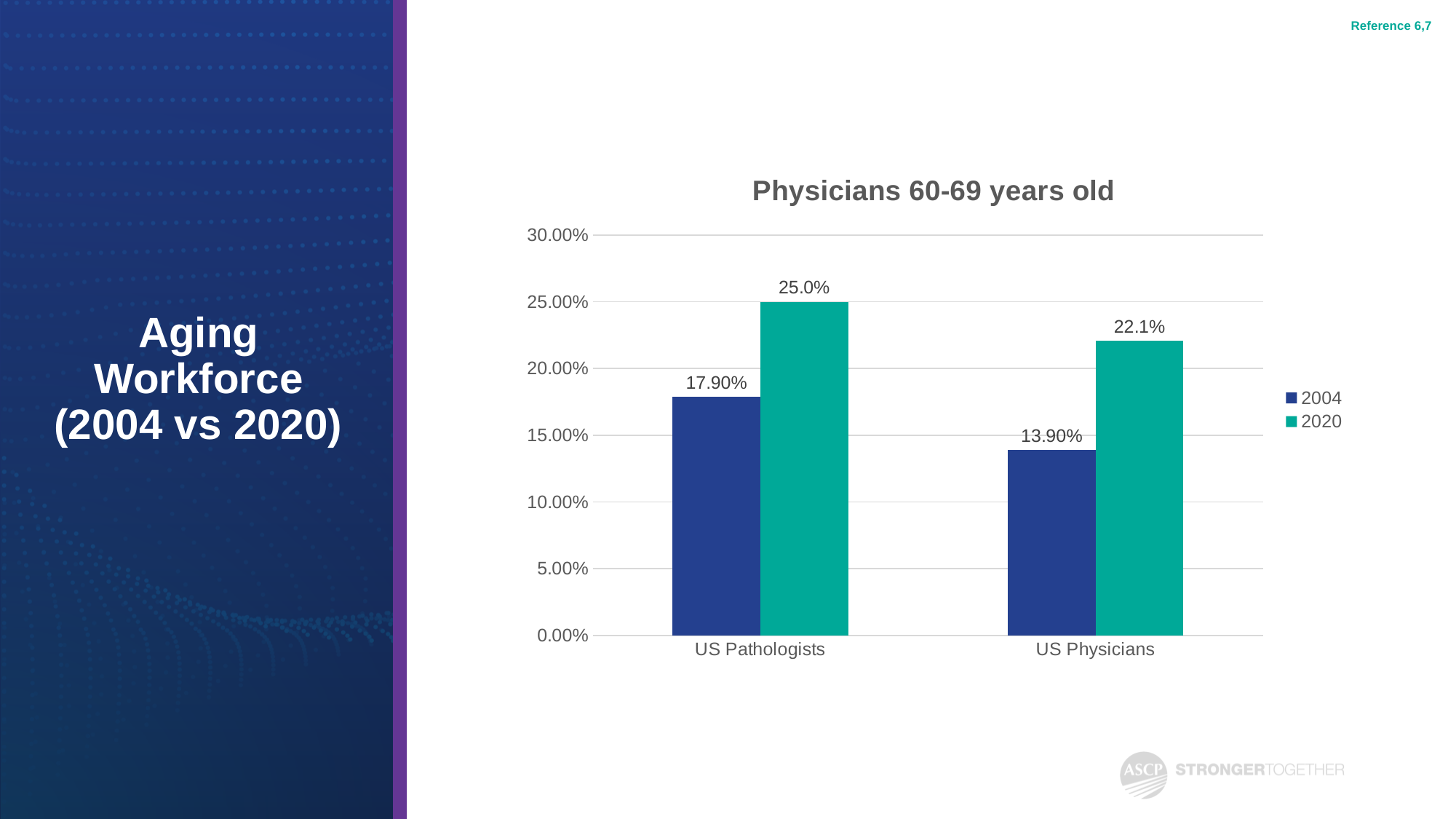
What is the value for US Physicians in 2004? 13.90% How many categories are shown on the x axis? 2 Is the 2020 value for US Physicians greater or less than 20.00%? greater What is the value for US Physicians in 2020? 22.1% What is the title of the chart? Physicians 60-69 years old What is the value for US Pathologists in 2020? 25.0% How many series does the legend list? 2 Which category has the highest value in the 2020 series? US Pathologists What is the difference between the 2020 and 2004 values for US Pathologists? 7.1 percentage points Which category has the lowest value in the 2004 series? US Physicians Which is larger: the 2004 value for US Pathologists or the 2004 value for US Physicians? US Pathologists What is the value for US Pathologists in 2004? 17.90%